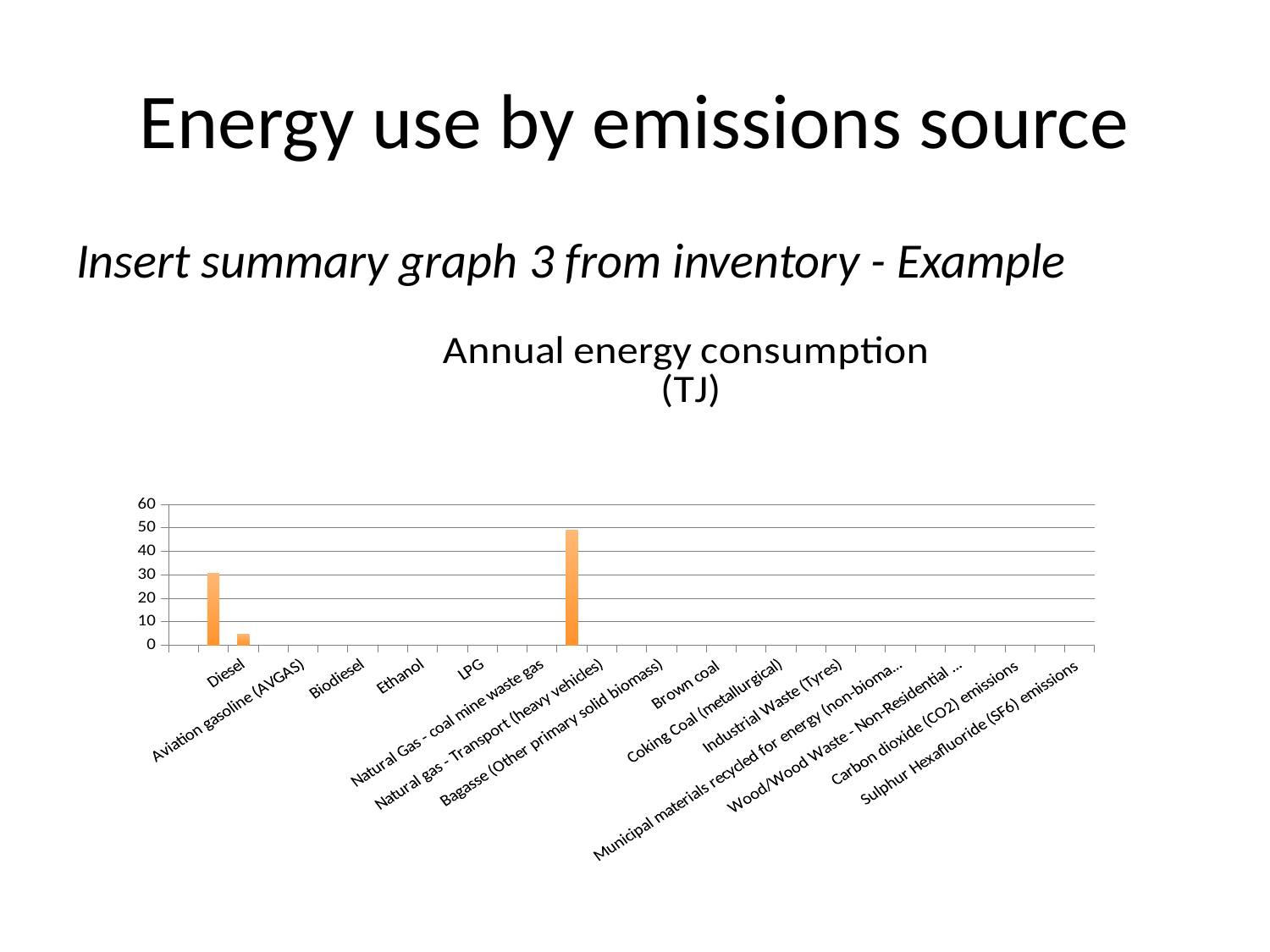
Is the value for Natural gas - Transport (heavy vehicles) greater or less than 40? less What is the title of the chart? Annual energy consumption (TJ) What kind of chart is shown on the slide? bar chart Is the value for Diesel greater or less than 20? less Which is larger, the value for Diesel or the value for Aviation gasoline (AVGAS)? Diesel Is the value for Diesel greater or less than 40? less Which is larger, the value for Natural gas - Transport (heavy vehicles) or the value for Diesel? Diesel What is the highest value shown on the vertical axis? 60